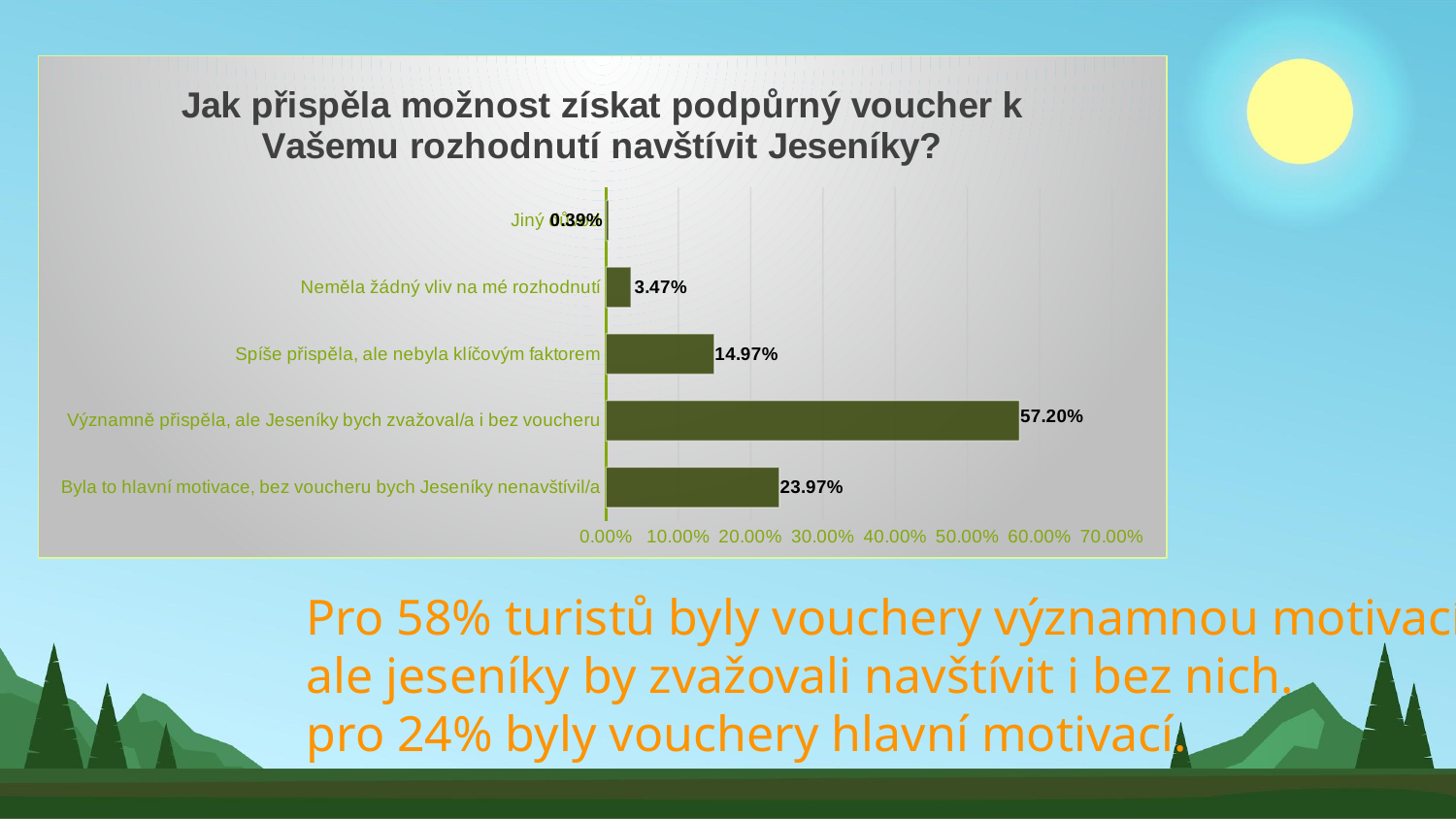
What is the value for "Neměla žádný vliv na mé rozhodnutí"? 3.47% What is the title of the chart? Jak přispěla možnost získat podpůrný voucher k Vašemu rozhodnutí navštívit Jeseníky? How many categories are shown in the chart? 5 Which category has the highest value? Významně přispěla, ale Jeseníky bych zvažoval/a i bez voucheru What type of chart is shown on the slide? bar chart Which is larger: the value for "Spíše přispěla, ale nebyla klíčovým faktorem" or for "Neměla žádný vliv na mé rozhodnutí"? Spíše přispěla, ale nebyla klíčovým faktorem What is the value for "Spíše přispěla, ale nebyla klíčovým faktorem"? 14.97% What is the value for "Byla to hlavní motivace, bez voucheru bych Jeseníky nenavštívil/a"? 23.97% What is the value for "Významně přispěla, ale Jeseníky bych zvažoval/a i bez voucheru"? 57.20% Which category has the lowest value? Jiný Is the value for "Významně přispěla, ale Jeseníky bych zvažoval/a i bez voucheru" greater or less than 50.00%? greater What is the difference between the values for "Významně přispěla, ale Jeseníky bych zvažoval/a i bez voucheru" and "Byla to hlavní motivace, bez voucheru bych Jeseníky nenavštívil/a"? 33.23%